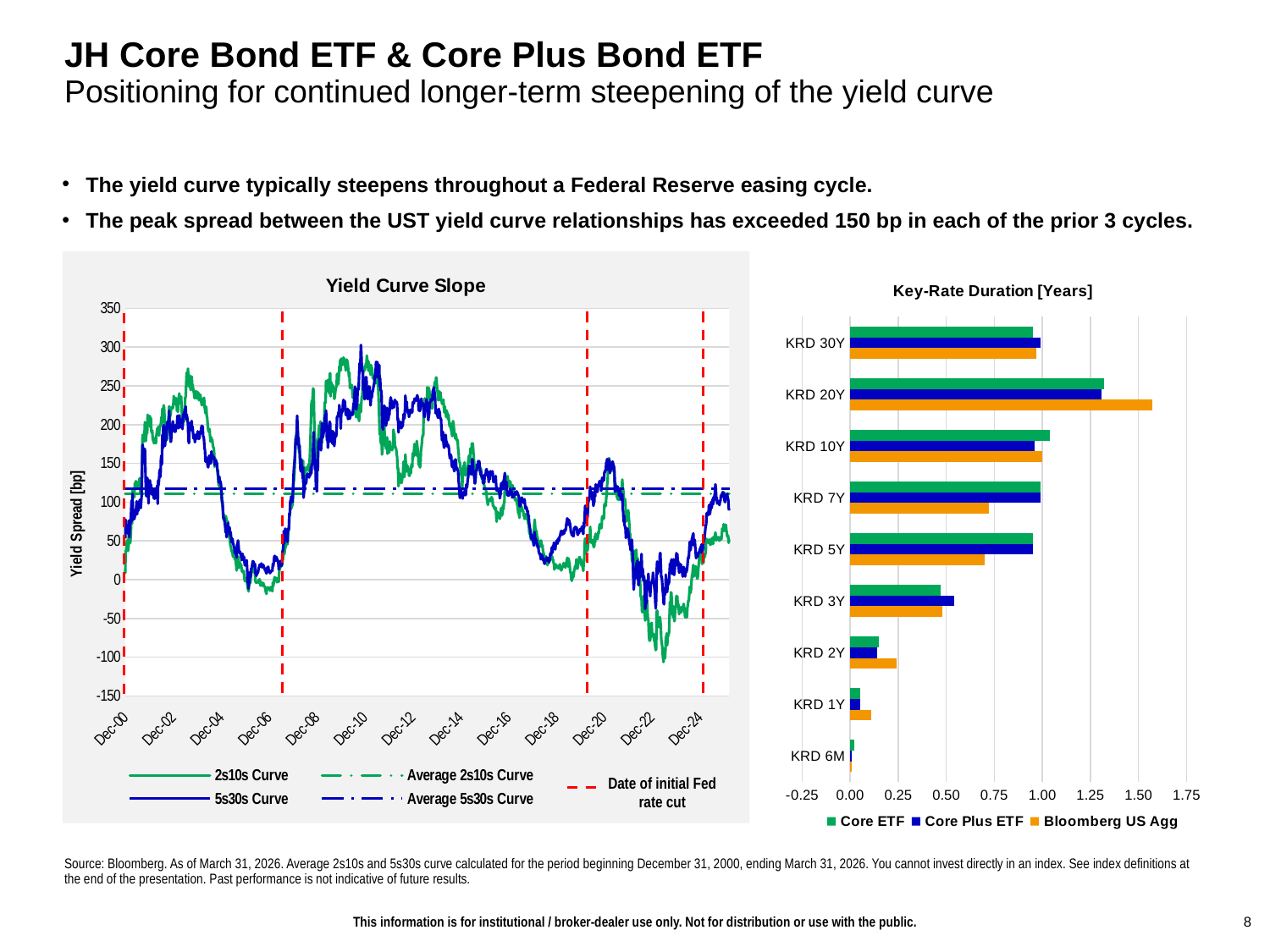
In the Yield Curve Slope chart, is the Average 5s30s Curve value greater or less than 100? greater In the Key-Rate Duration [Years] chart, for KRD 7Y, which is larger: Core ETF or Bloomberg US Agg? Core ETF What is the y-axis label of the Yield Curve Slope chart? Yield Spread [bp] In the Key-Rate Duration [Years] chart, is the Core ETF value for KRD 2Y greater or less than 0.25? less In the Key-Rate Duration [Years] chart, which category has the lowest Core ETF value? KRD 6M How many series does the legend of the Key-Rate Duration [Years] chart list? 3 In the Key-Rate Duration [Years] chart, is the Bloomberg US Agg value for KRD 20Y greater or less than 1.25? greater What kind of chart is the Key-Rate Duration [Years] chart? bar chart In the Key-Rate Duration [Years] chart, for KRD 2Y, which is larger: Bloomberg US Agg or Core ETF? Bloomberg US Agg How many key-rate duration categories are shown on the Key-Rate Duration [Years] chart? 9 In the Key-Rate Duration [Years] chart, which series has the longest bar for KRD 20Y? Bloomberg US Agg What kind of chart is the Yield Curve Slope chart? line chart